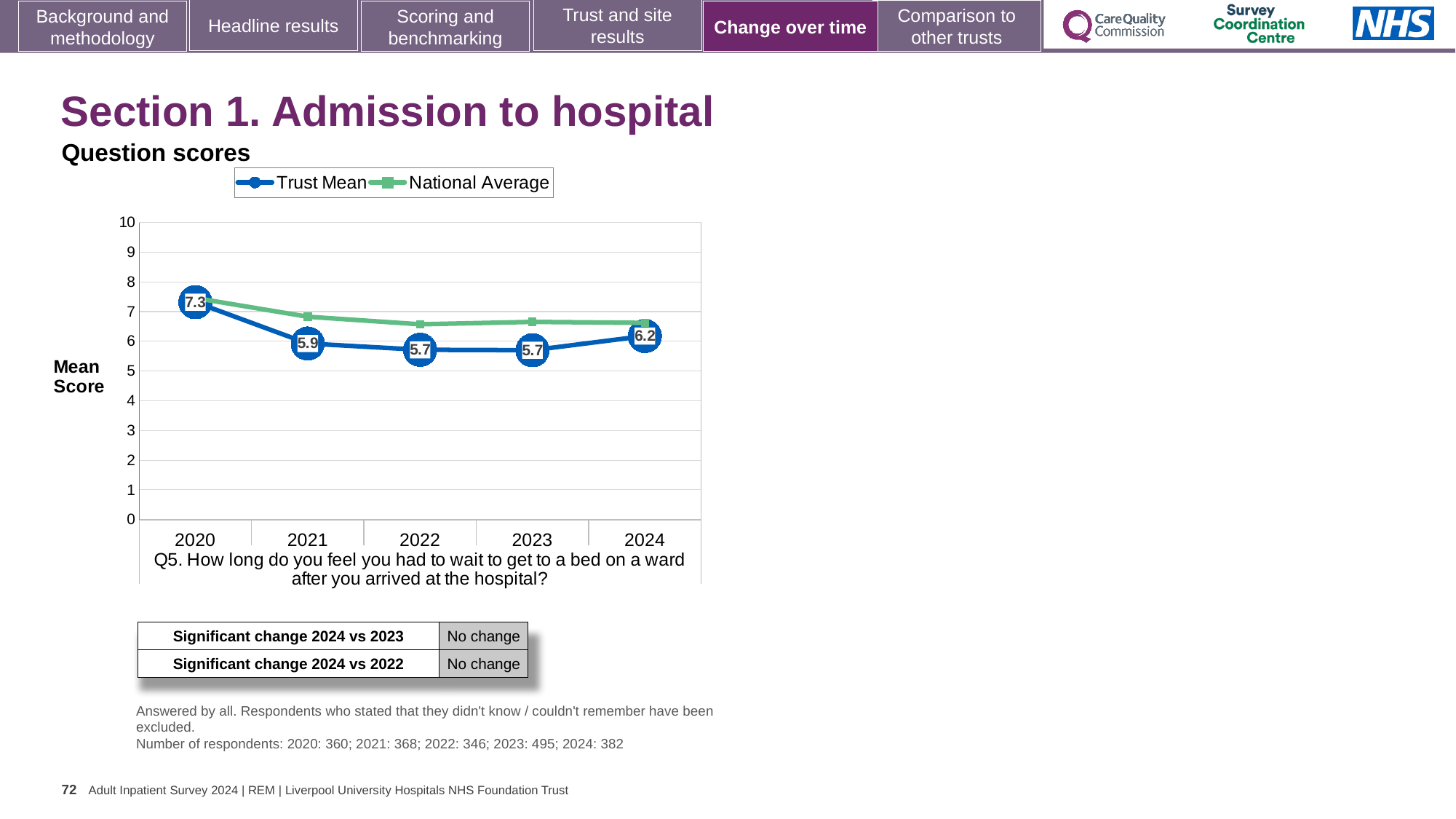
How many series does the legend list? 2 Does the Trust Mean score rise or fall from 2020 to 2022? Fall What is the Trust Mean score for 2021? 5.9 What is the Trust Mean score for 2024? 6.2 In which year is the Trust Mean score highest? 2020 How many years are plotted on the x axis? 5 What is the difference between the Trust Mean score in 2020 and in 2024? 1.1 Which year has the larger Trust Mean score, 2021 or 2024? 2024 Is the National Average value for 2021 greater or less than 6? greater What is the lowest Trust Mean score shown on the chart? 5.7 What kind of chart is shown on the slide? Line chart What is the Trust Mean score for 2020? 7.3